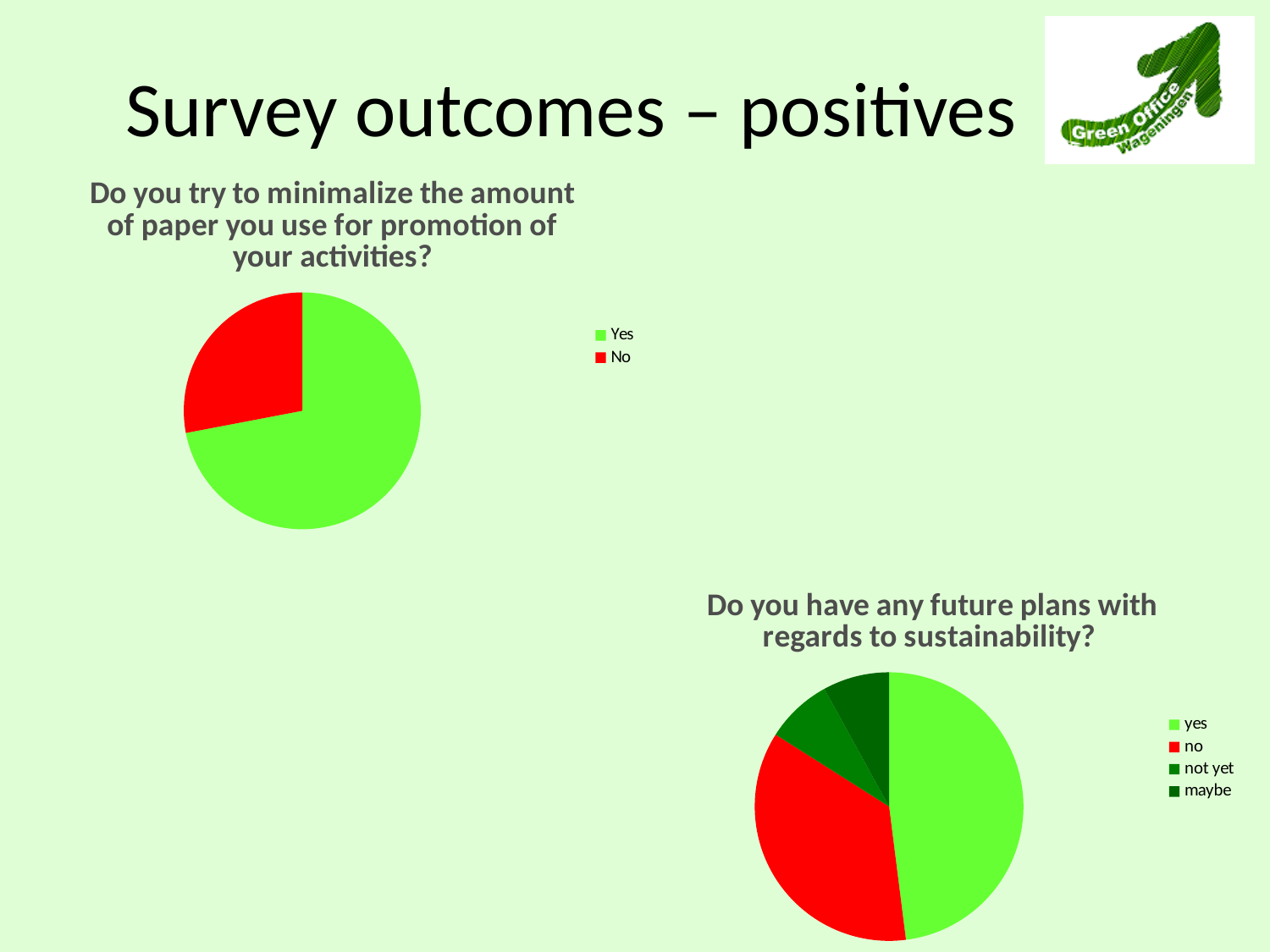
What are the legend entries of the chart 'Do you have any future plans with regards to sustainability?'? yes, no, not yet, maybe How many pie charts are shown on the slide? 2 What kind of chart is used for 'Do you have any future plans with regards to sustainability?'? Pie chart In the chart 'Do you try to minimalize the amount of paper you use for promotion of your activities?', which colour represents 'No'? Red In the chart 'Do you have any future plans with regards to sustainability?', which answer has the largest slice? yes In the chart 'Do you try to minimalize the amount of paper you use for promotion of your activities?', which answer has the largest slice? Yes What kind of chart is used for 'Do you try to minimalize the amount of paper you use for promotion of your activities?'? Pie chart How many entries does the legend list for the chart 'Do you try to minimalize the amount of paper you use for promotion of your activities?'? 2 In the chart 'Do you try to minimalize the amount of paper you use for promotion of your activities?', which answer has the smallest slice? No In the chart 'Do you have any future plans with regards to sustainability?', which slice is larger, 'no' or 'not yet'? no How many categories are shown in the chart 'Do you have any future plans with regards to sustainability?'? 4 In the chart 'Do you have any future plans with regards to sustainability?', which slice is larger, 'yes' or 'no'? yes